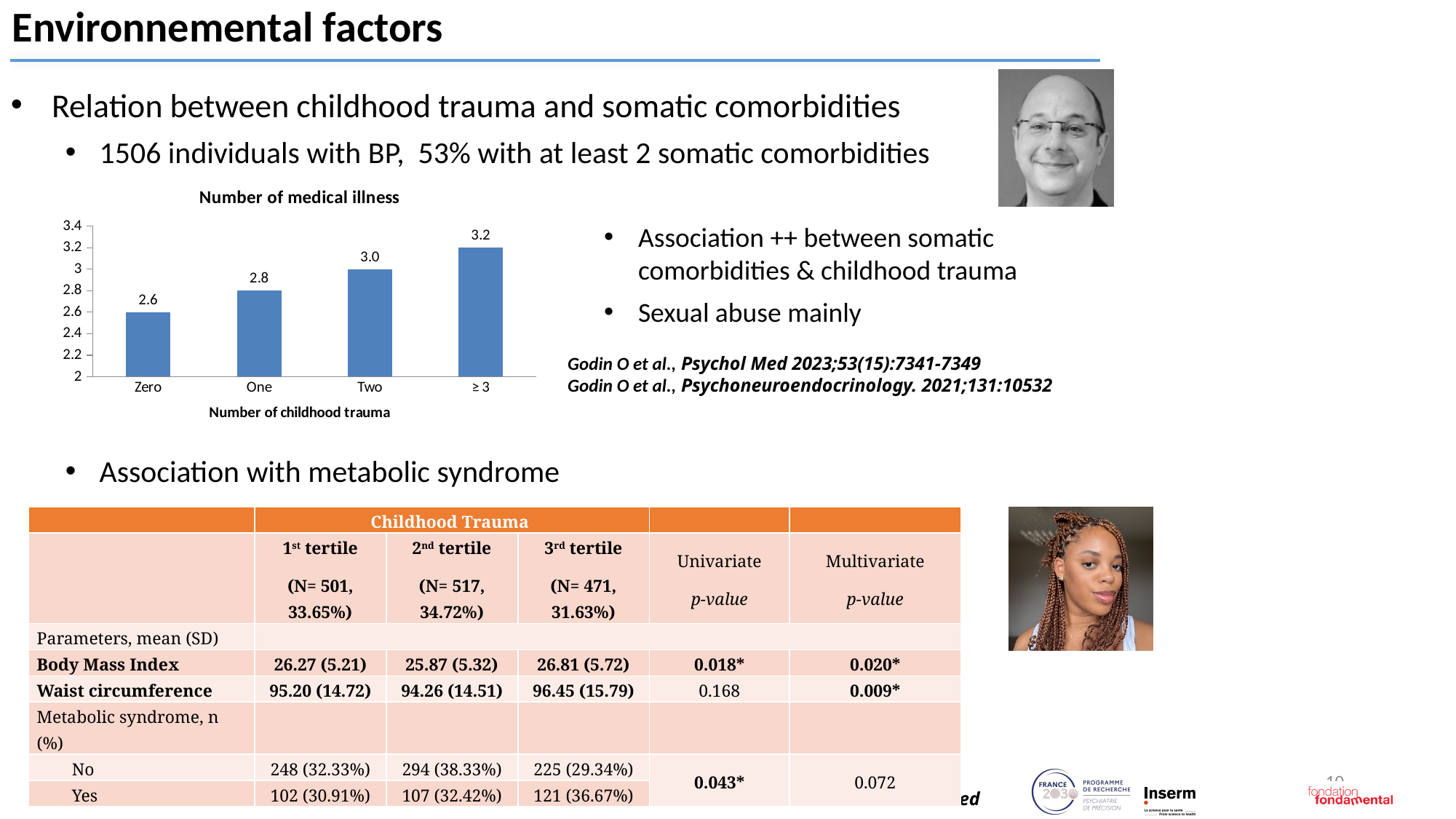
How many categories of number of childhood trauma are shown on the x axis? 4 What is the title of the chart? Number of medical illness Which childhood trauma category has the highest number of medical illness? ≥ 3 What is the number of medical illness for individuals with ≥ 3 childhood traumas? 3.2 What is the number of medical illness for individuals with zero childhood traumas? 2.6 Does the number of medical illness rise or fall as the number of childhood trauma increases? Rise What is the number of medical illness for individuals with two childhood traumas? 3.0 What is the difference in number of medical illness between the ≥ 3 and Zero childhood trauma categories? 0.6 Which childhood trauma category has the lowest number of medical illness? Zero What is the number of medical illness for individuals with one childhood trauma? 2.8 Which has a higher number of medical illness: One childhood trauma or Two childhood traumas? Two What kind of chart is used to show the number of medical illness? Bar chart